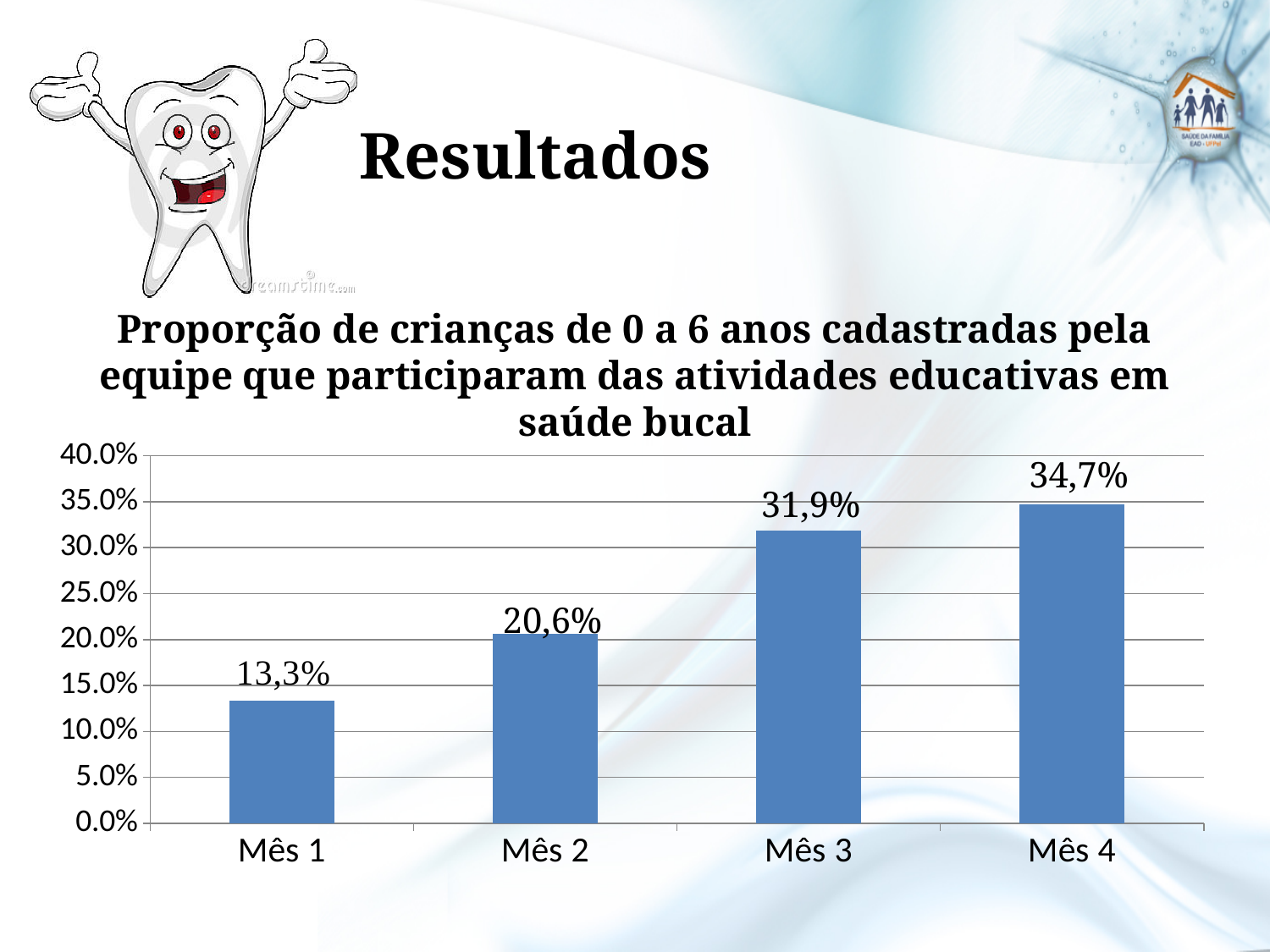
What is the value for Mês 3? 31,9% What kind of chart is shown on the slide? bar chart Do the values rise or fall from Mês 1 to Mês 4? rise What is the difference between the values for Mês 2 and Mês 1? 7,3% What is the value for Mês 4? 34,7% What is the difference between the values for Mês 4 and Mês 3? 2,8% Which is larger, the value for Mês 2 or the value for Mês 3? Mês 3 What is the value for Mês 1? 13,3% Which month has the lowest value? Mês 1 Is the value for Mês 2 greater or less than 25.0%? less Which month has the highest value? Mês 4 How many months are shown on the x axis? 4